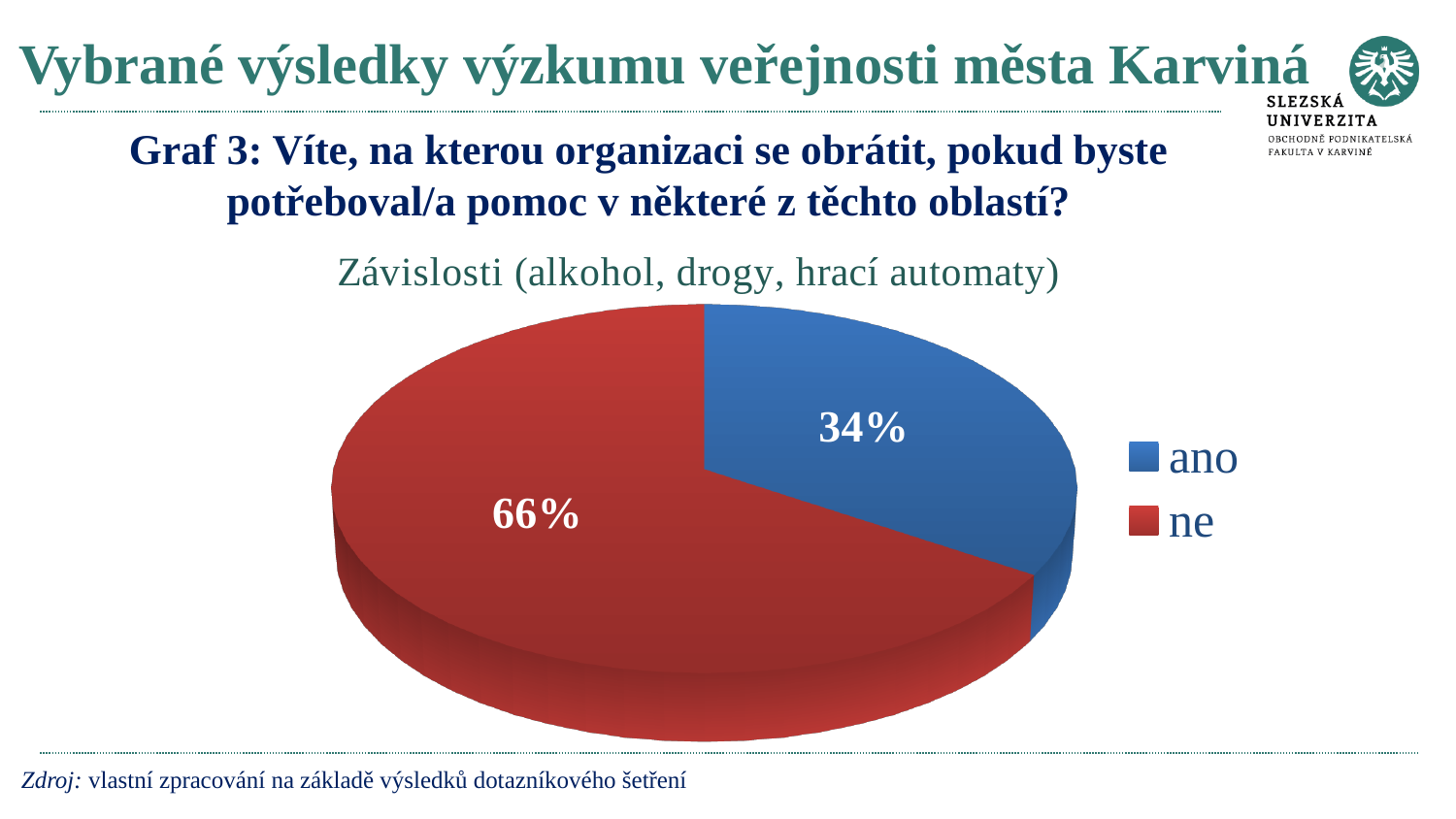
What colour is the "ano" slice in the pie chart? blue How many categories does the pie chart show? 2 Which category has the largest share of the pie? ne What share of the pie does the "ne" slice represent? 66% Which is larger, the share for "ano" or the share for "ne"? ne What type of chart is shown on the slide? pie chart What is the difference between the "ne" and "ano" shares? 32% What is the value for "ano" in the pie chart? 34% What is the title of the pie chart? Závislosti (alkohol, drogy, hrací automaty) Which category has the smallest share of the pie? ano How many entries does the legend list? 2 What is the value for "ne" in the pie chart? 66%